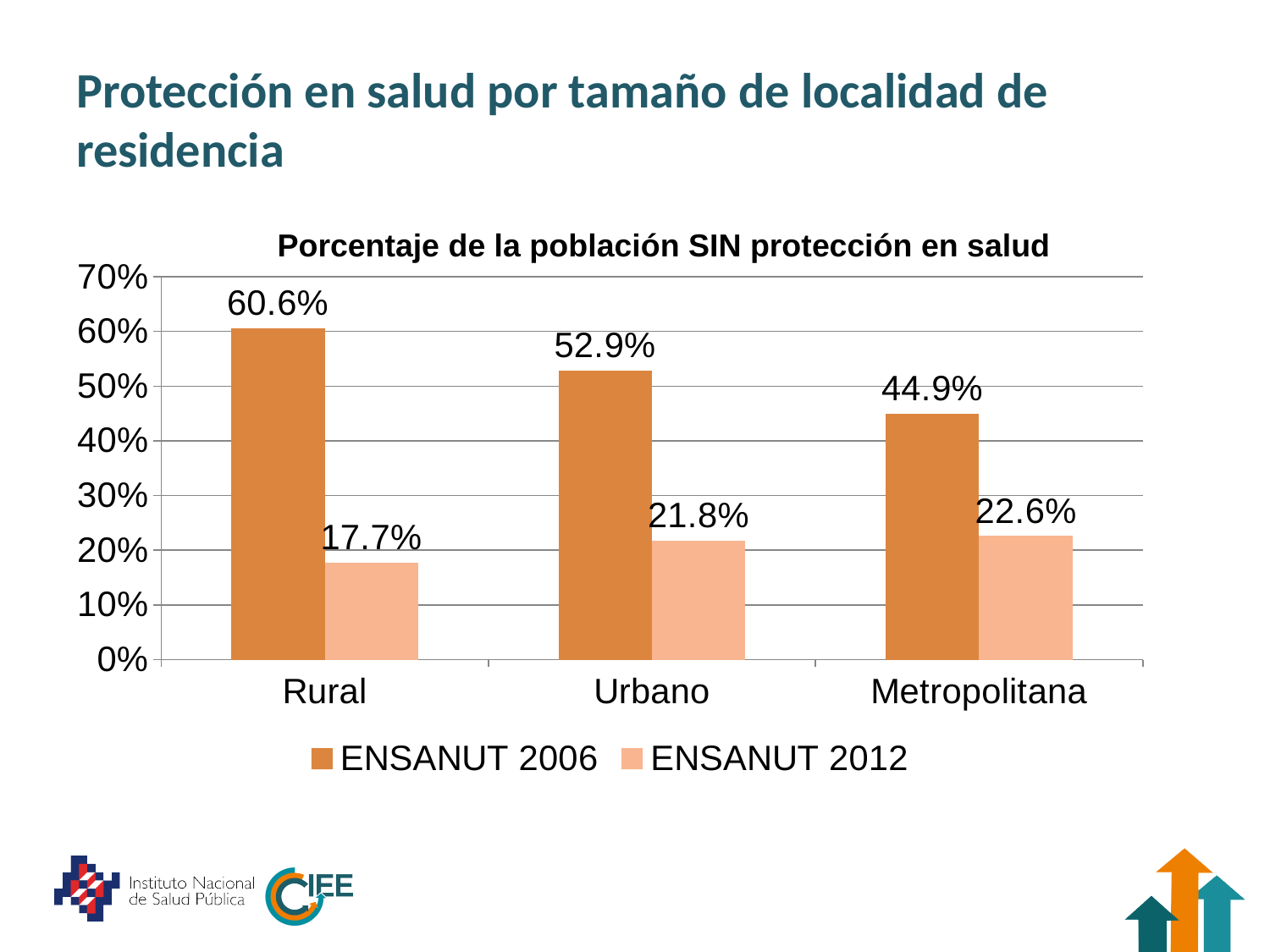
Which locality has the highest ENSANUT 2006 value? Rural What kind of chart is shown on the slide? bar chart What is the ENSANUT 2012 value for Urbano? 21.8% What is the difference between the ENSANUT 2006 values for Urbano and Metropolitana? 8.0% How many series does the legend list? 2 What is the difference between the ENSANUT 2006 and ENSANUT 2012 values for Rural? 42.9% Is the ENSANUT 2006 value for Metropolitana greater or less than 50%? less How many locality categories are shown on the x axis? 3 What is the ENSANUT 2012 value for Metropolitana? 22.6% What is the ENSANUT 2006 value for Rural? 60.6% Which locality has the lowest ENSANUT 2012 value? Rural Which is larger: the ENSANUT 2006 value for Urbano or for Metropolitana? Urbano